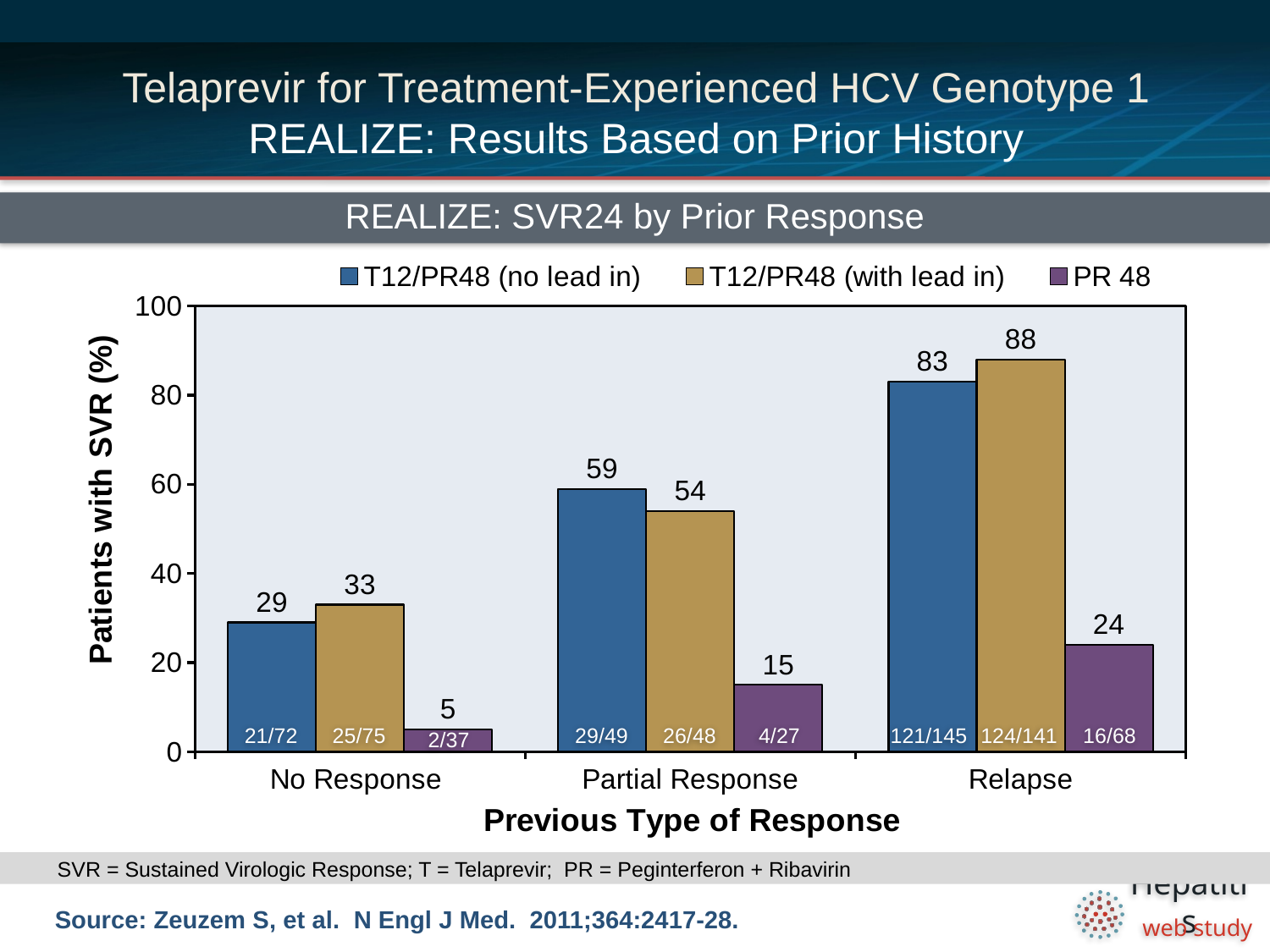
What is the title of the chart? REALIZE: SVR24 by Prior Response What is the SVR rate for T12/PR48 (with lead in) in the Partial Response group? 54 Which prior response category has the highest SVR rate for T12/PR48 (with lead in)? Relapse Which prior response category has the lowest SVR rate for PR 48? No Response Do the SVR rates for PR 48 rise or fall from No Response to Relapse? Rise How many prior response categories are shown on the x axis? 3 In the Partial Response group, which is larger: the SVR rate for T12/PR48 (no lead in) or T12/PR48 (with lead in)? T12/PR48 (no lead in) What kind of chart is shown on the slide? Bar chart What is the difference between the T12/PR48 (with lead in) and PR 48 SVR rates in the Relapse group? 64 How many series does the legend list? 3 What is the SVR rate for PR 48 in the Relapse group? 24 What is the SVR rate for T12/PR48 (no lead in) in the No Response group? 29